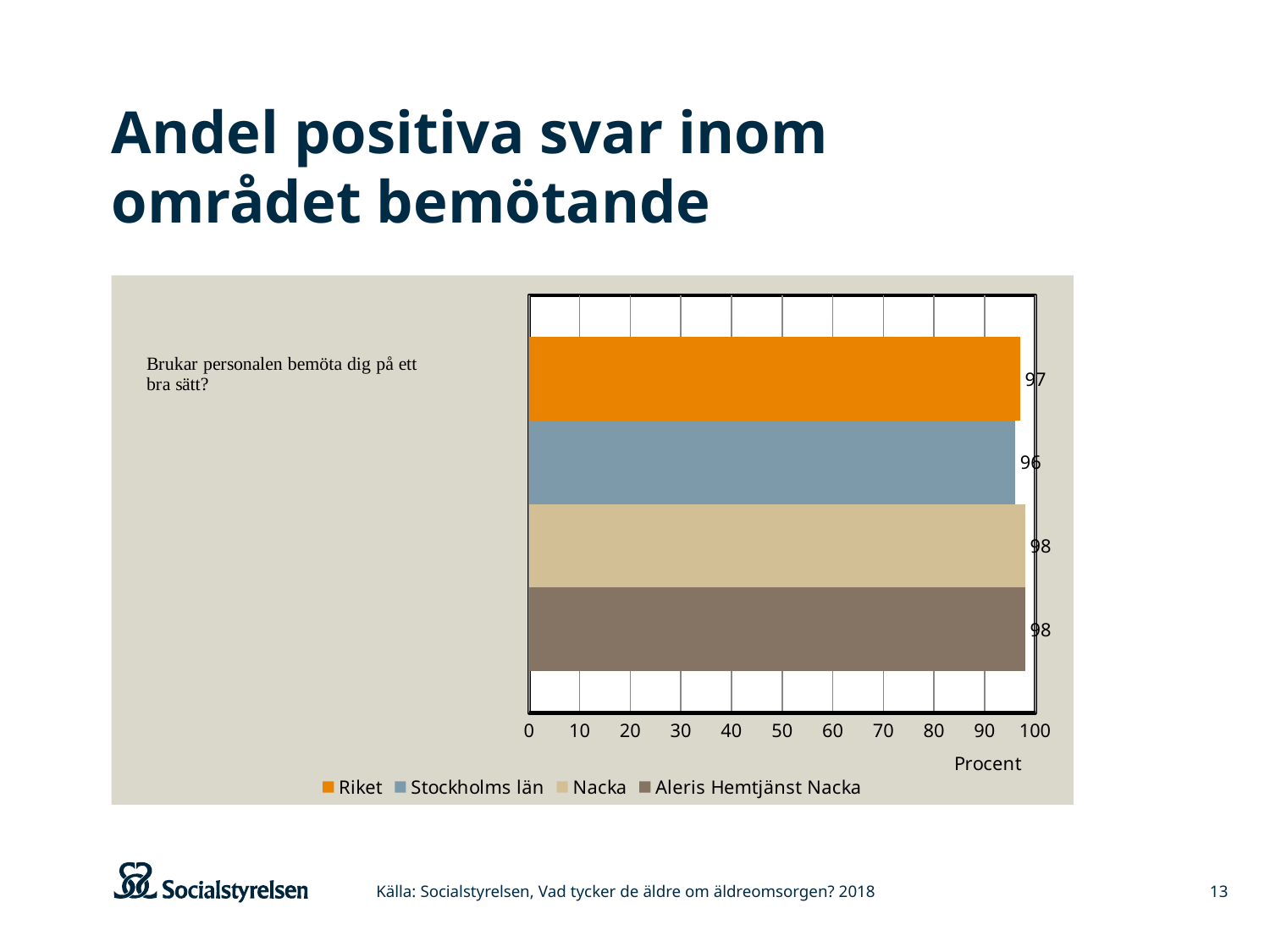
What is the value for Stockholms län? 96 What is the value for Riket? 97 What is the value for Nacka? 98 Which is larger, the value for Riket or the value for Stockholms län? Riket What is the value for Aleris Hemtjänst Nacka? 98 What is the difference between the values for Nacka and Stockholms län? 2 What kind of chart is shown on the slide? bar chart Is the value for Stockholms län greater or less than 90? greater How many series does the legend list? 4 Which series has the lowest value? Stockholms län What is the difference between the values for Riket and Stockholms län? 1 What is the label of the x axis? Procent